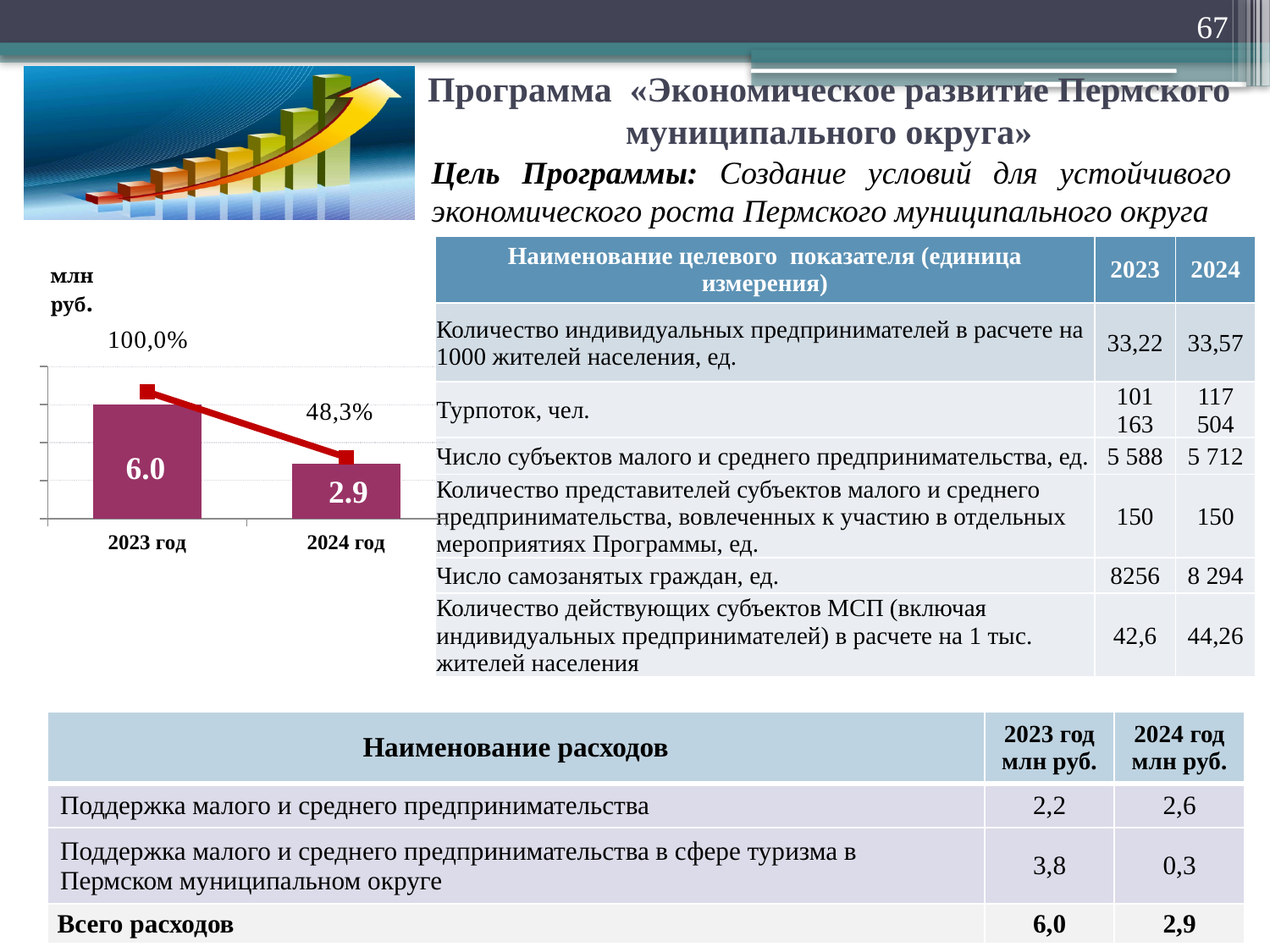
What kind of chart is shown on the left of the slide? combination bar and line chart Is the bar value for 2023 год larger or smaller than the value for 2024 год? larger What percentage label is shown above the 2024 год point on the line in the chart? 48,3% How many bars are plotted in the chart? 2 What is the value for 2024 год in the bar chart? 2.9 By how much does the bar value for 2023 год exceed the value for 2024 год? 3.1 Which year has the higher bar in the chart? 2023 год What unit is indicated at the top of the chart's axis? млн руб. What percentage label is shown above the 2023 год point on the line in the chart? 100,0% Which year has the lower bar in the chart? 2024 год Do the bar values rise or fall from 2023 год to 2024 год? fall What is the value for 2023 год in the bar chart? 6.0